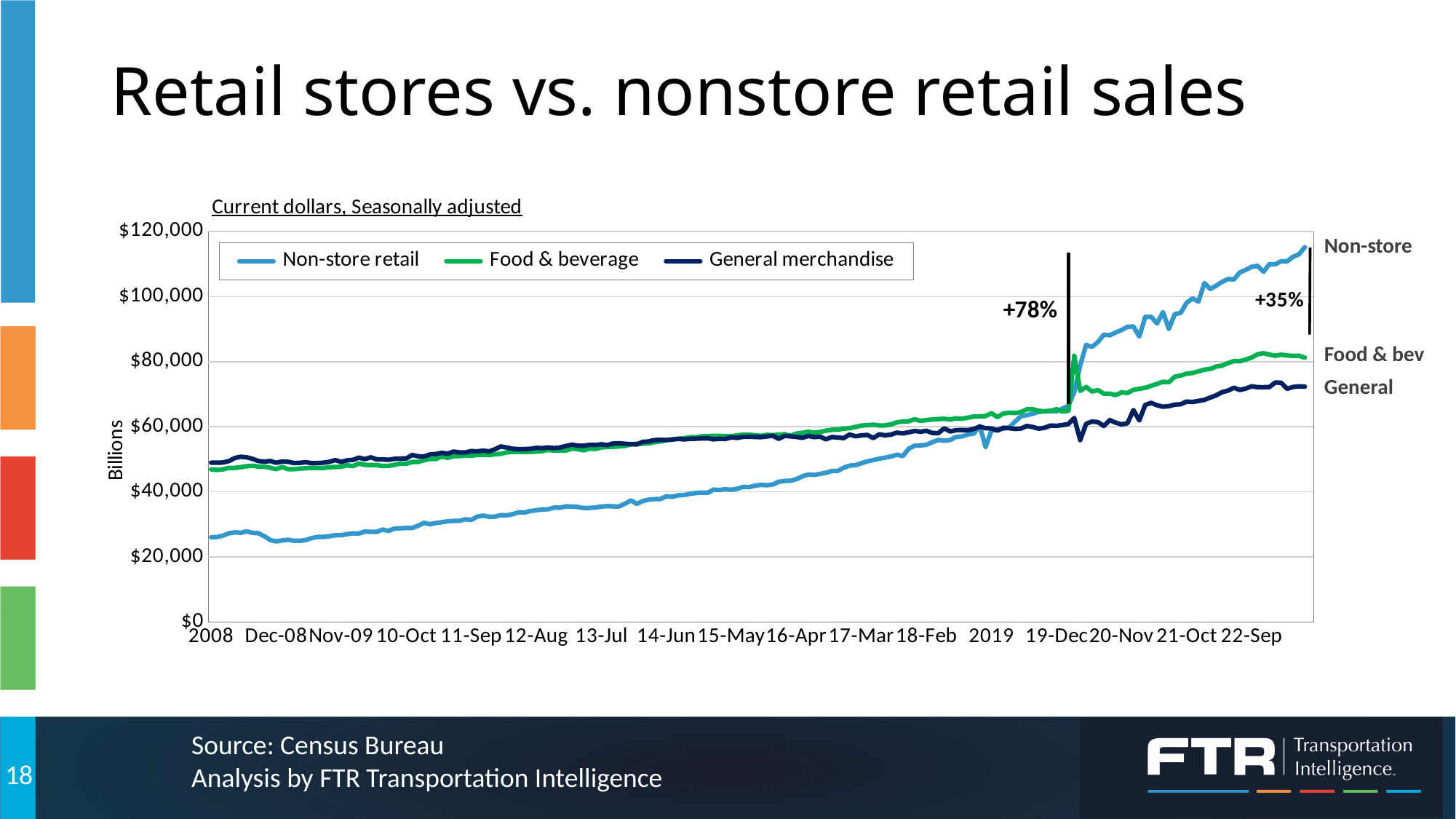
How many series does the legend list? 3 What kind of chart is shown on the slide? line chart At the end of the series, which is larger: Non-store retail or General merchandise? Non-store retail Is the value for General merchandise at the end of the series greater or less than $80,000? less What is the label on the vertical axis of the chart? Billions What is the title of the slide's chart? Current dollars, Seasonally adjusted What percentage increase is annotated at the right end of the Non-store retail line? +35% In 2008, which is larger: General merchandise or Non-store retail? General merchandise Is the value for Non-store retail at the start of the series (2008) greater or less than $40,000? less What percentage increase is annotated on the Non-store retail line near 19-Dec? +78% Which series has the highest value at the right end of the chart? Non-store retail Is the value for Non-store retail at the end of the series (22-Sep) greater or less than $100,000? greater